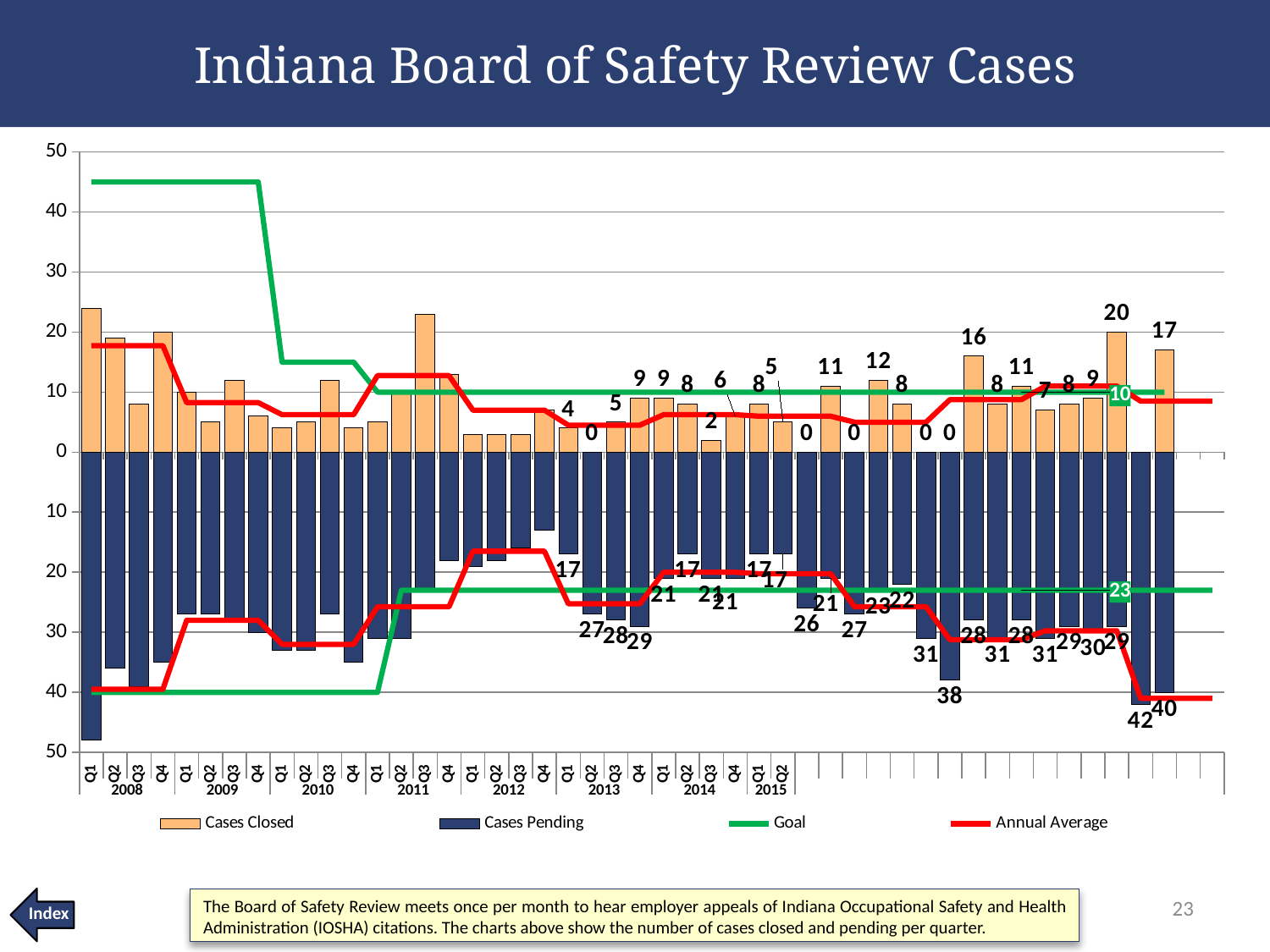
What is the Cases Closed value for Q2 2013? 0 How many series does the legend list? 4 What is the title of the chart? Indiana Board of Safety Review Cases What kind of chart is used to show Cases Closed and Cases Pending? Bar chart What is the Goal value labeled for Cases Pending at the right end of the chart? 23 Is the Cases Pending value for Q1 2008 greater or less than 40? greater Is the Cases Closed value for Q1 2008 greater or less than 20? greater What is the highest Cases Closed value labeled on the chart? 20 What is the Cases Pending value for Q4 2013? 29 What is the Cases Closed value for Q4 2014? 6 What is the Cases Closed value for Q1 2013? 4 What is the highest Cases Pending value labeled on the chart? 42